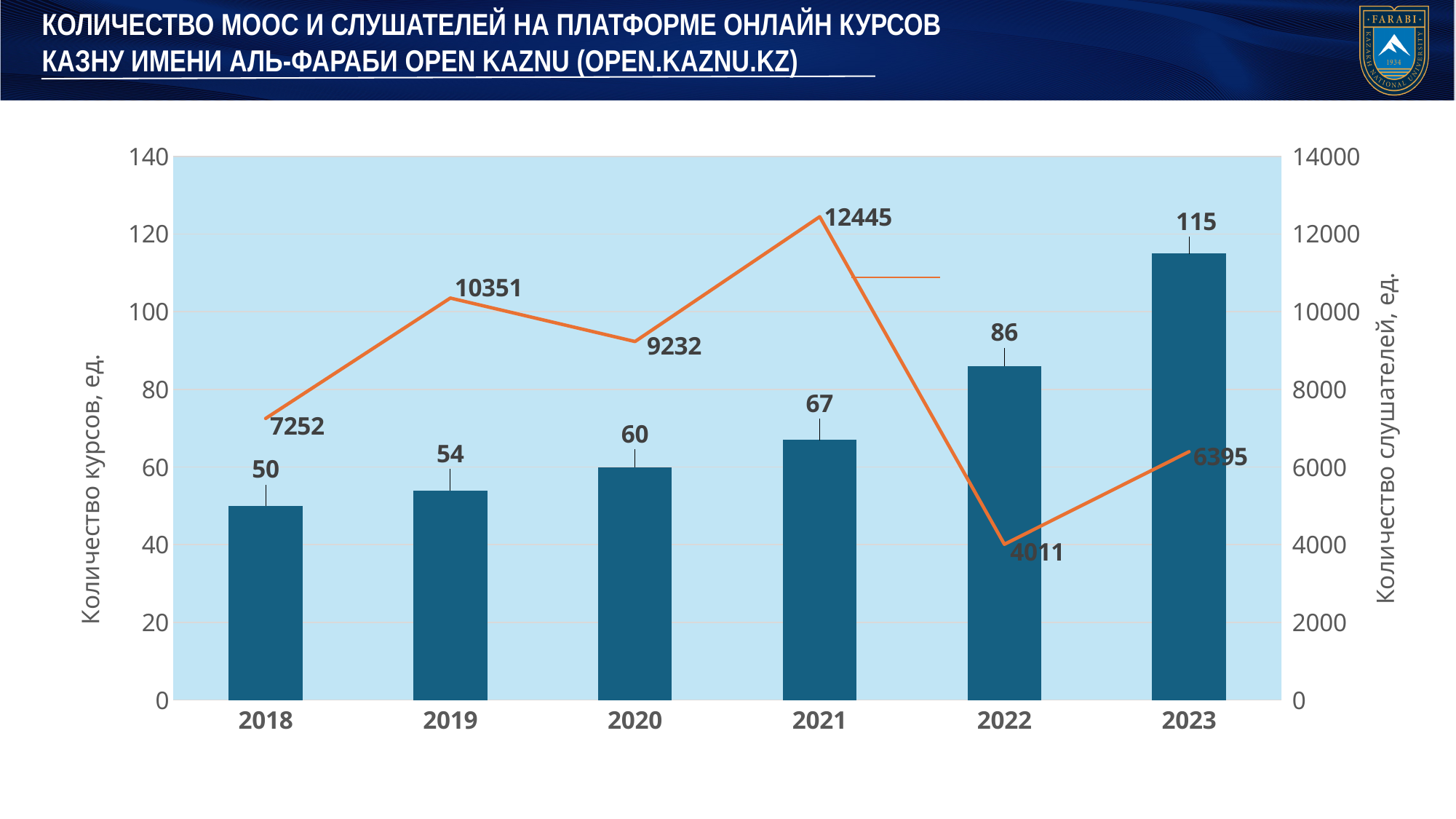
What is the difference in the number of courses between 2023 and 2022? 29 What is the number of listeners (line value) for 2021? 12445 Do the bar values (number of courses) rise or fall from 2018 to 2023? rise What is the number of courses (bar value) for 2023? 115 How many years are shown on the x axis? 6 What is the number of listeners (line value) for 2022? 4011 What is the difference in the number of listeners between 2021 and 2022? 8434 What is the title of the right-hand vertical axis? Количество слушателей, ед. Which year has the highest number of listeners (line)? 2021 Which year has the highest number of courses (bars)? 2023 Which year has more listeners, 2019 or 2020? 2019 Which year has the lowest number of listeners (line)? 2022